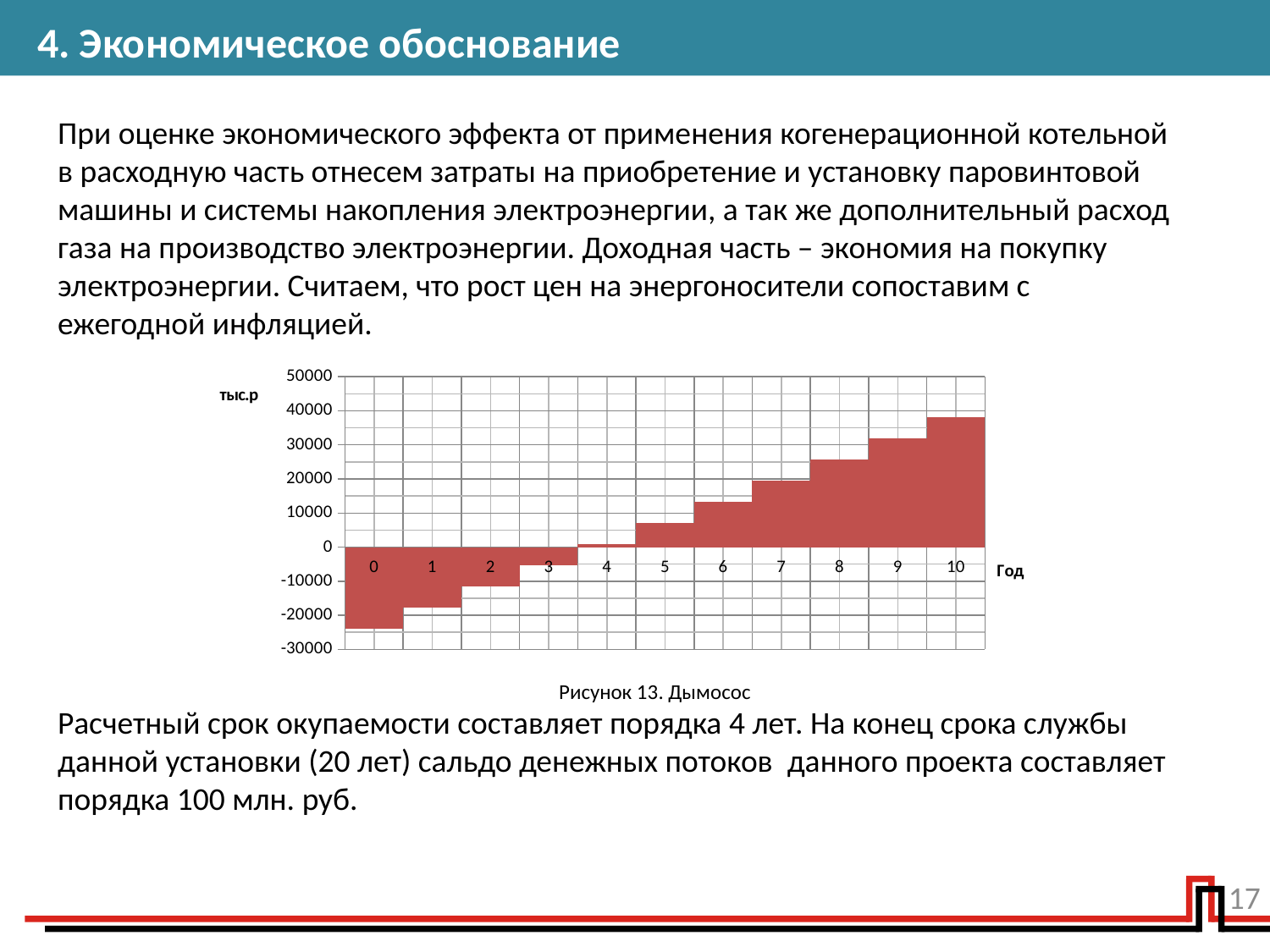
What kind of chart is shown on the slide? bar chart What unit label is shown on the vertical axis of the chart? тыс.р Which year has the lowest value in the chart? 0 Is the value for year 3 greater or less than 0? less Which is larger, the value for year 8 or the value for year 5? year 8 What is the caption printed below the chart? Рисунок 13. Дымосос Is the value for year 6 greater or less than 10000? greater Is the value for year 0 greater or less than -20000? less Which year has the highest value in the chart? 10 How many years (categories) are plotted along the x axis of the chart? 11 Do the values rise or fall as the year increases along the x axis? rise